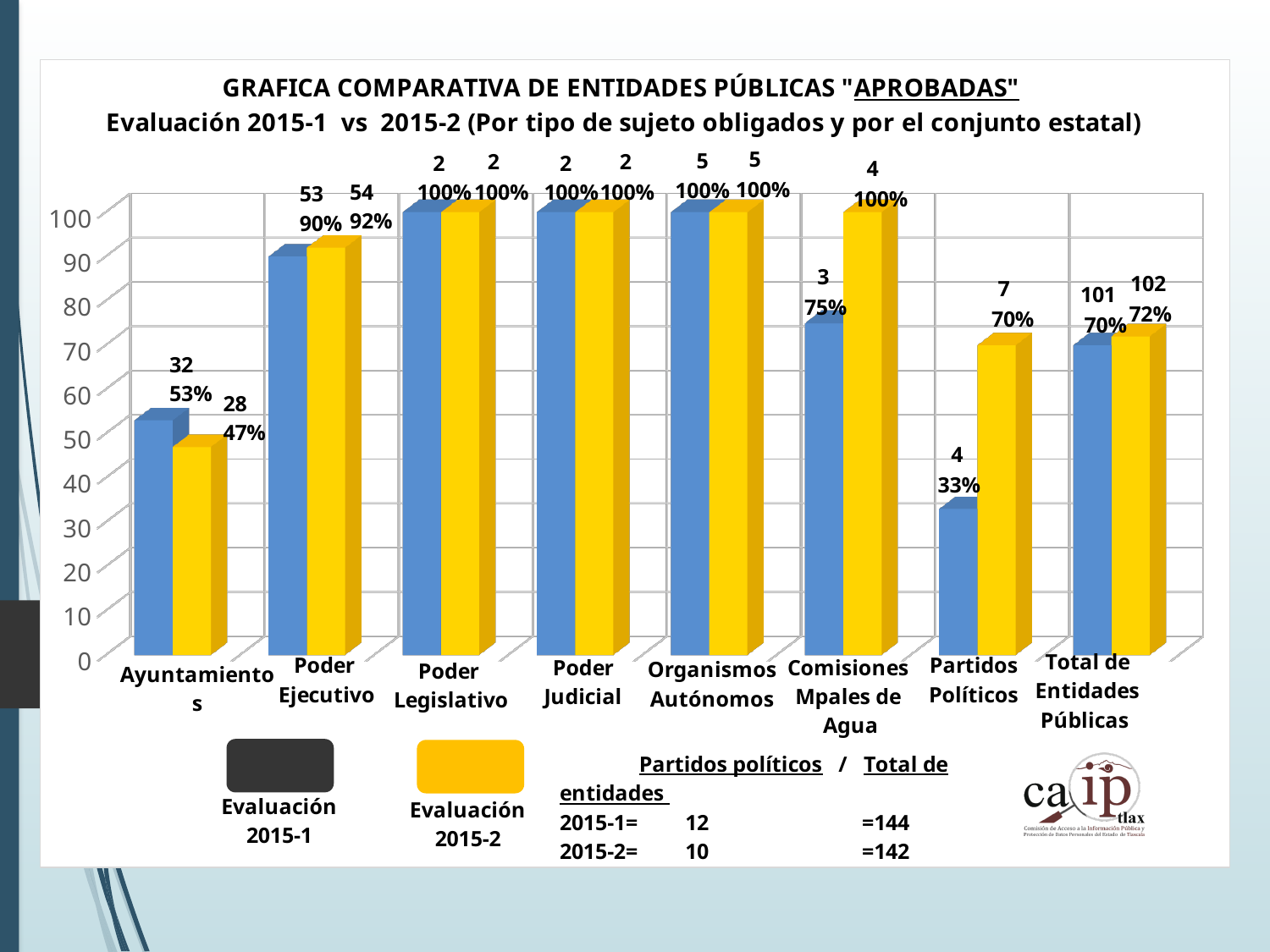
For Ayuntamientos, which evaluation has the higher percentage, 2015-1 or 2015-2? 2015-1 What is the difference in percentage points between Evaluación 2015-2 and Evaluación 2015-1 for Partidos Políticos? 37 Which category has the lowest percentage in Evaluación 2015-2? Ayuntamientos What percentage is shown for Ayuntamientos in Evaluación 2015-1? 53% What percentage is shown for Comisiones Mpales de Agua in Evaluación 2015-1? 75% What kind of chart is shown on the slide? Bar chart How many categories are shown on the x axis? 8 Which category has the lowest percentage in Evaluación 2015-1? Partidos Políticos What count is labelled for Poder Ejecutivo in Evaluación 2015-2? 54 What percentage is shown for Total de Entidades Públicas in Evaluación 2015-2? 72% How many series does the legend list? 2 What percentage is shown for Partidos Políticos in Evaluación 2015-2? 70%